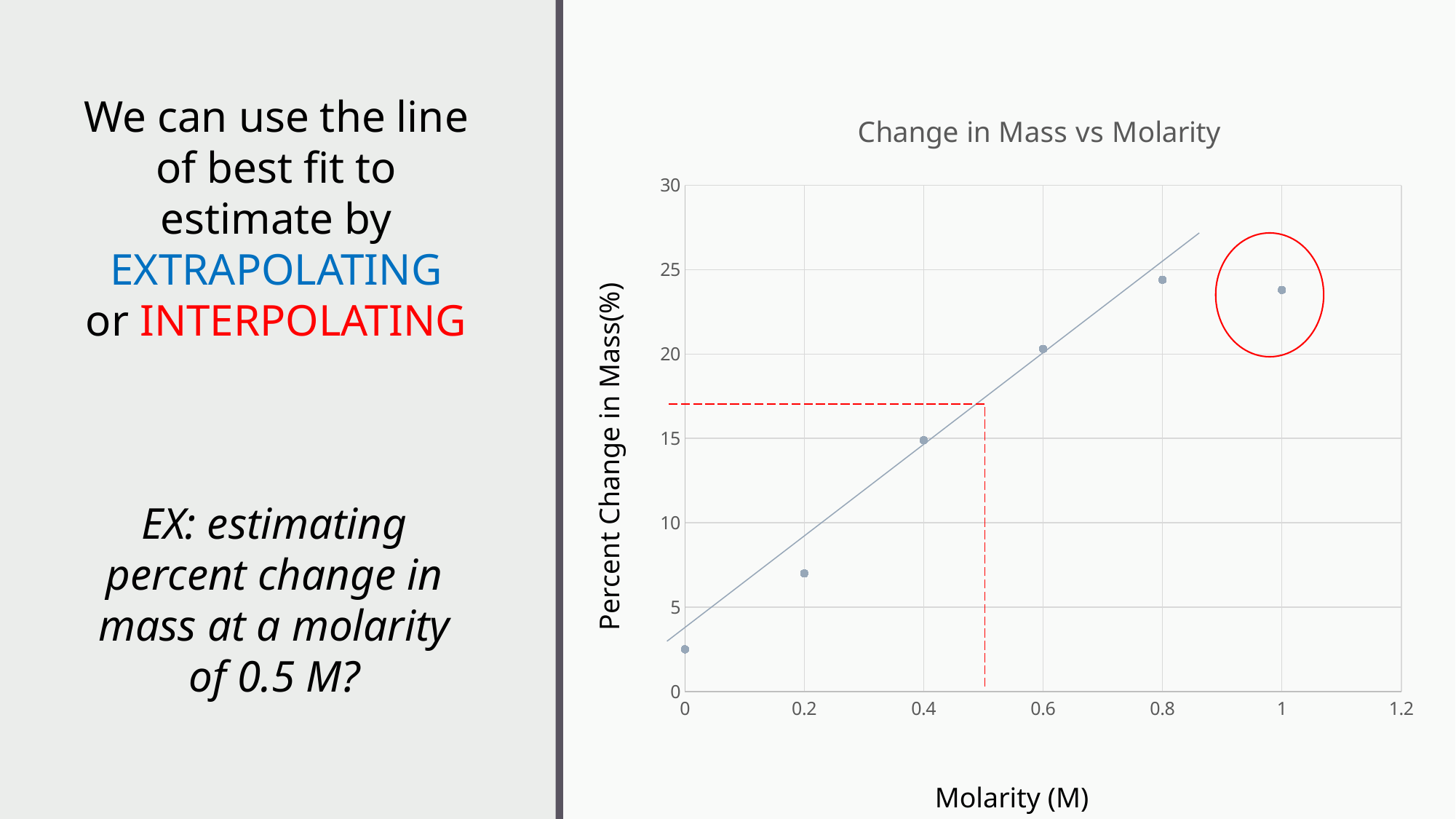
Is the percent change in mass at a molarity of 0.8 M greater or less than 25? less Is the percent change in mass at a molarity of 0.2 M greater or less than 10? less Is the percent change in mass at a molarity of 1 M greater or less than 20? greater What kind of chart is shown on the slide? scatter plot What is the label of the x axis? Molarity (M) Which has a larger percent change in mass, a molarity of 0.4 M or 0.6 M? 0.6 M Does the percent change in mass generally rise or fall as molarity increases from 0 to 0.8 M? rise How many data points are plotted on the chart? 6 Which molarity has the lowest percent change in mass? 0 What is the title of the chart? Change in Mass vs Molarity